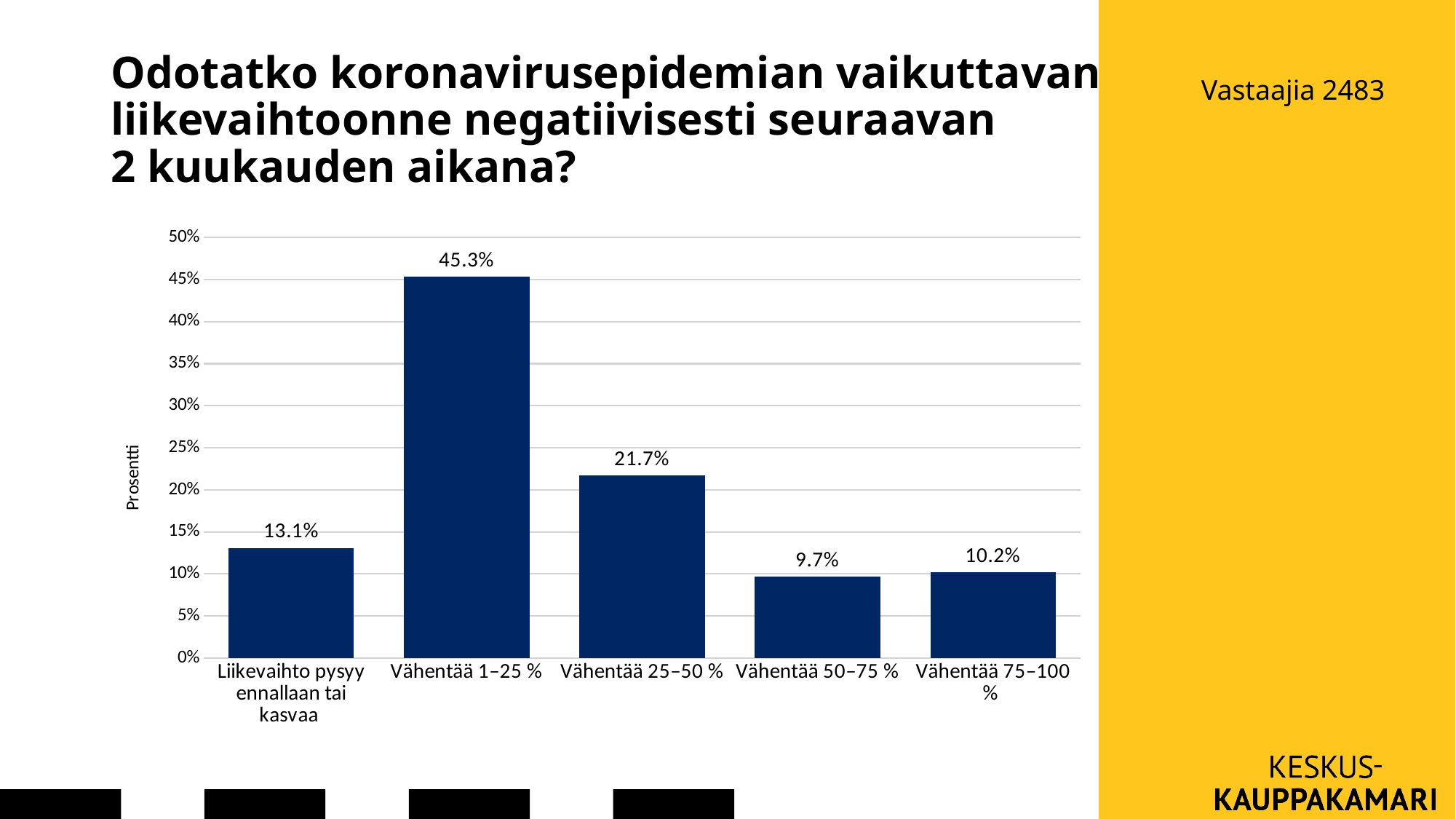
What is the value for "Vähentää 1–25 %"? 45.3% How many respondents (Vastaajia) are stated on the slide? 2483 What is the value for "Vähentää 50–75 %"? 9.7% Is the value for "Vähentää 25–50 %" greater or less than 20%? greater What is the label of the vertical axis? Prosentti What kind of chart is shown on the slide? bar chart Which category has the lowest value? Vähentää 50–75 % What is the difference between the values for "Vähentää 1–25 %" and "Vähentää 25–50 %"? 23.6% Which is larger, the value for "Liikevaihto pysyy ennallaan tai kasvaa" or the value for "Vähentää 75–100 %"? Liikevaihto pysyy ennallaan tai kasvaa How many categories are shown on the x axis? 5 Which category has the highest value? Vähentää 1–25 % What is the value for "Liikevaihto pysyy ennallaan tai kasvaa"? 13.1%